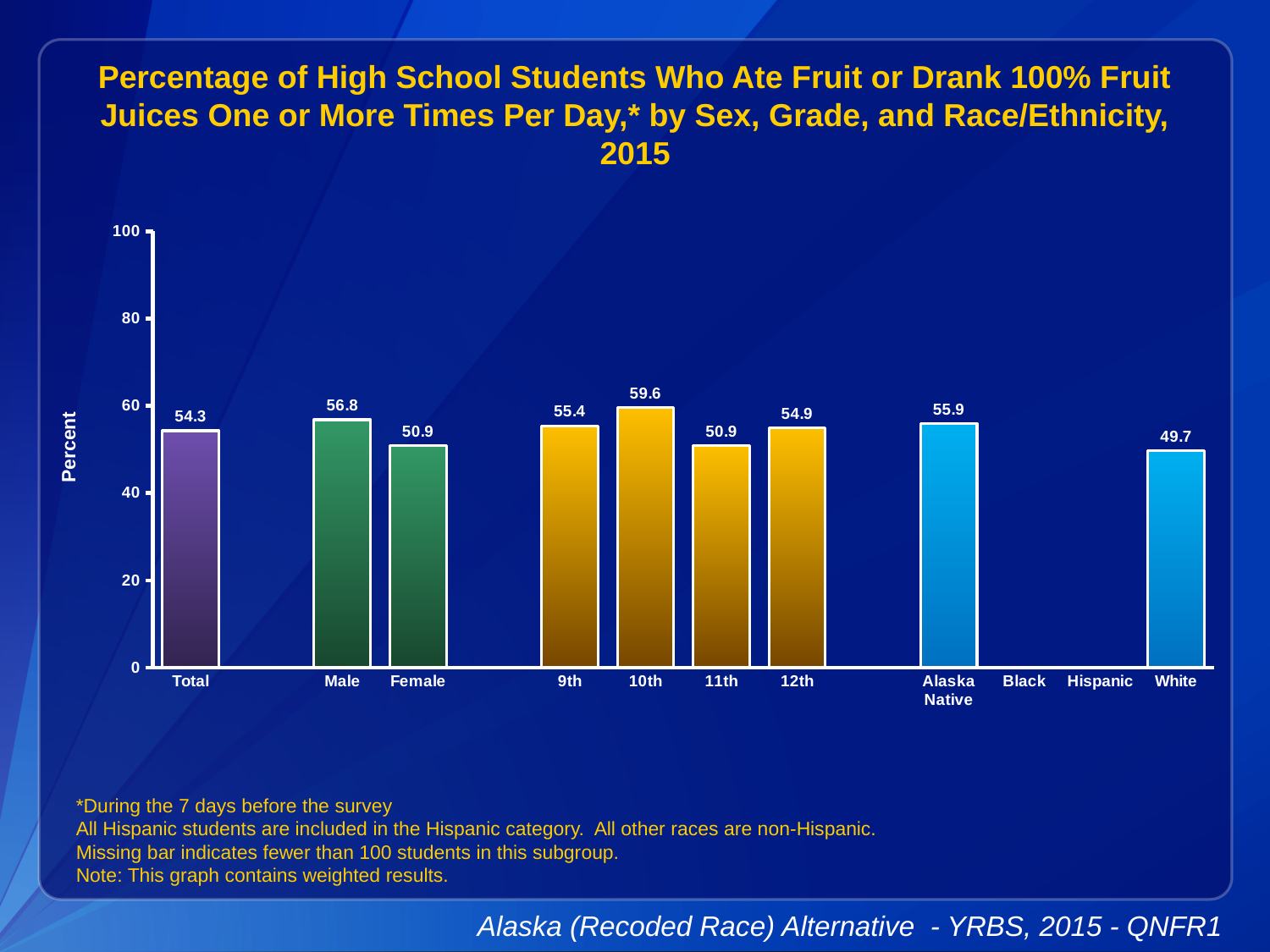
Which category has the highest value? 10th What is the value for 10th grade? 59.6 What kind of chart is shown? bar chart What is the difference between the Male and Female values? 5.9 What is the value for Male? 56.8 What is the value for Alaska Native? 55.9 Is the value for White greater or less than 60? less Which category has the lowest value among the bars shown? White What is the value for Total? 54.3 How many bars are plotted on the chart? 9 What is the label of the y axis? Percent Which is larger, the value for 9th grade or the value for 12th grade? 9th